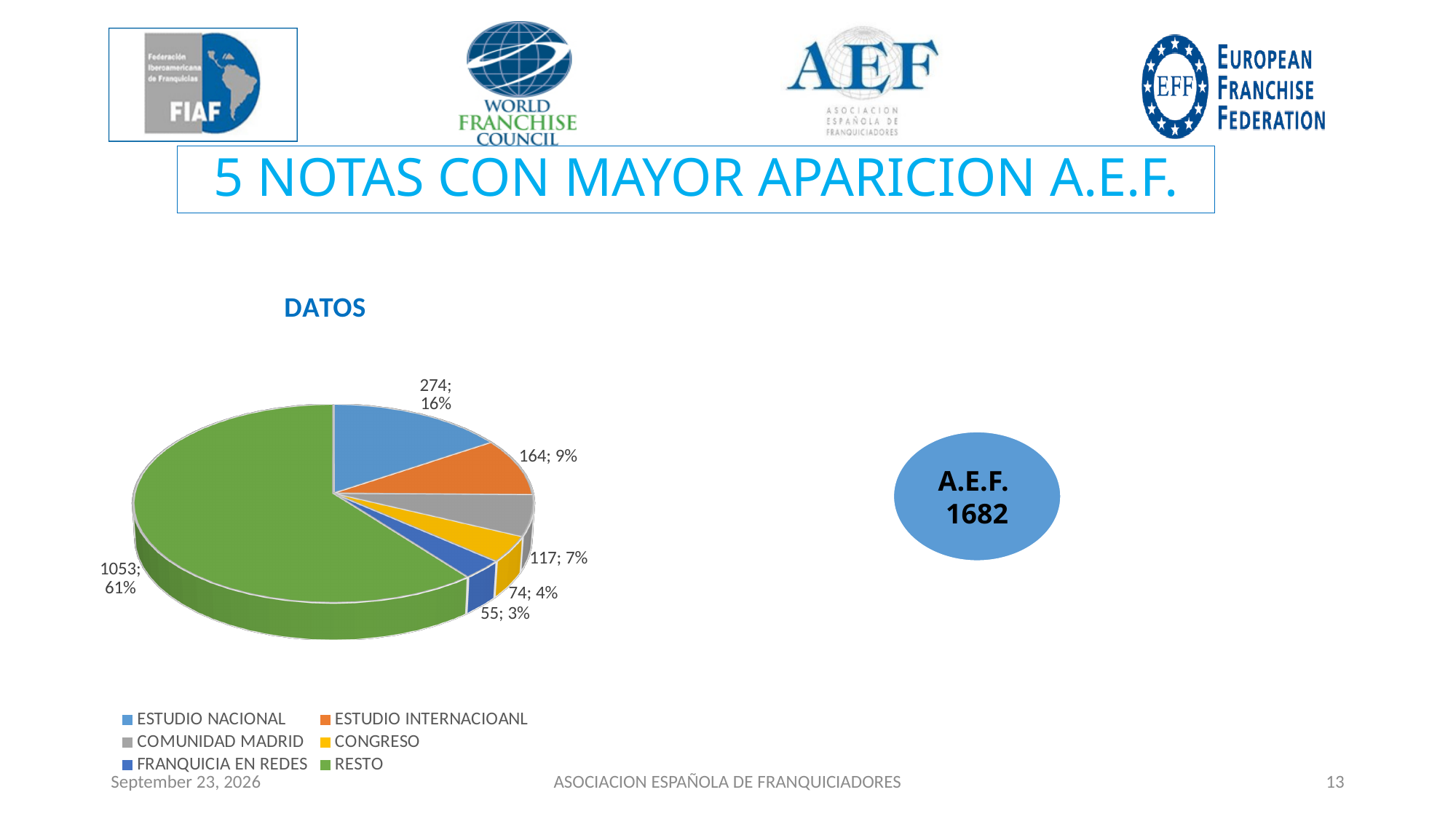
What share of the pie does CONGRESO represent? 4% What is the value for COMUNIDAD MADRID? 117 Which category has the smallest slice? FRANQUICIA EN REDES What is the difference between the values for ESTUDIO NACIONAL and ESTUDIO INTERNACIOANL? 110 What share of the pie does RESTO represent? 61% What is the value for ESTUDIO INTERNACIOANL? 164 Which is larger, the value for CONGRESO or the value for FRANQUICIA EN REDES? CONGRESO What kind of chart is shown on the slide? pie chart What is the title of the chart? DATOS What is the value for ESTUDIO NACIONAL? 274 Which category has the largest slice? RESTO How many slices does the pie chart have? 6